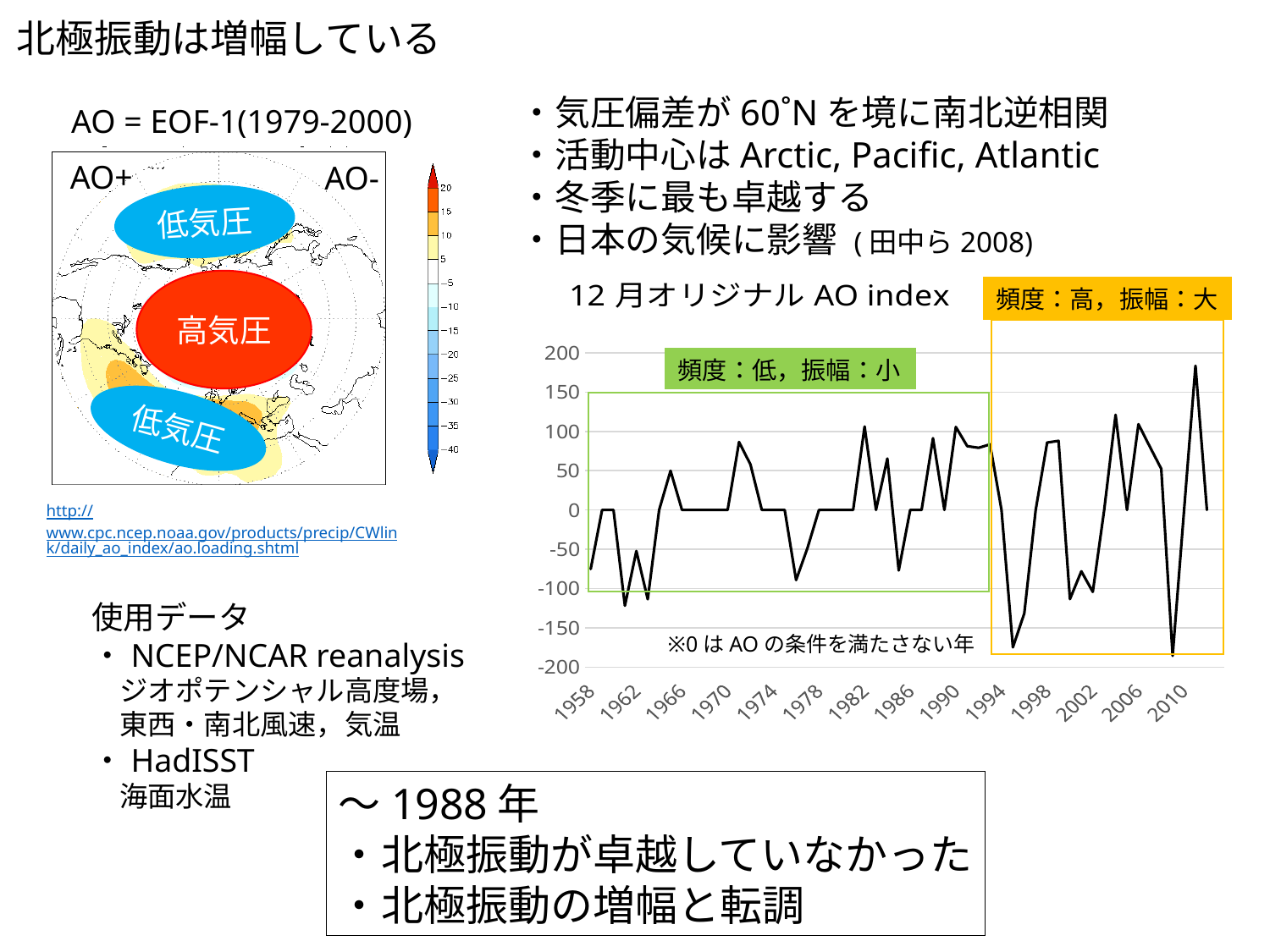
What is the highest value labeled on the y axis of the "12月オリジナル AO index" chart? 200 In the "12月オリジナル AO index" chart, is the highest value plotted greater or less than 150? greater What kind of chart is the "12月オリジナル AO index" chart? line chart What text is written in the green box over the left part of the "12月オリジナル AO index" chart? 頻度：低，振幅：小 How many year labels are shown on the x axis of the "12月オリジナル AO index" chart? 14 In the "12月オリジナル AO index" chart, is the value at 1978 greater or less than -50? greater In the "12月オリジナル AO index" chart, is the value at 1958 greater or less than 0? less What text is written in the orange box over the right part of the "12月オリジナル AO index" chart? 頻度：高，振幅：大 In the "12月オリジナル AO index" chart, do the swings of the line get larger or smaller toward the right end of the x axis? larger What is the lowest value labeled on the y axis of the "12月オリジナル AO index" chart? -200